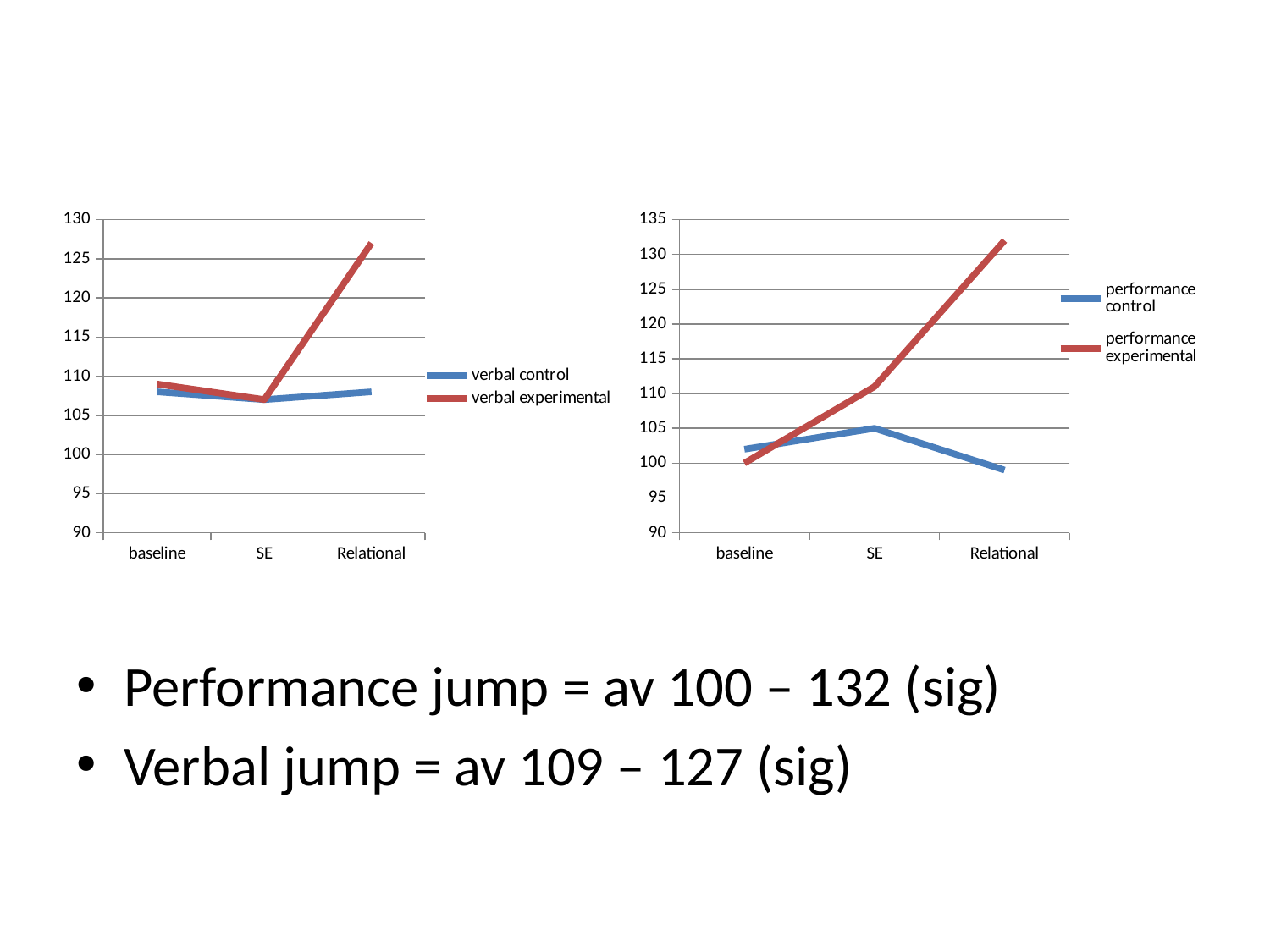
How many categories are on the x axis of the left chart? 3 In the right chart, at which category does performance experimental reach its highest value? Relational In the right chart, does the performance control line rise or fall from SE to Relational? fall In the right chart, is the value for performance experimental at Relational greater or less than 130? greater In the left chart, which series is higher at Relational, verbal control or verbal experimental? verbal experimental In the left chart, is the value for verbal control at Relational greater or less than 110? less What kind of chart is the left chart? line chart In the left chart, does the verbal experimental line rise or fall from SE to Relational? rise In the left chart, is the value for verbal experimental at Relational greater or less than 125? greater How many series does the legend of the right chart list? 2